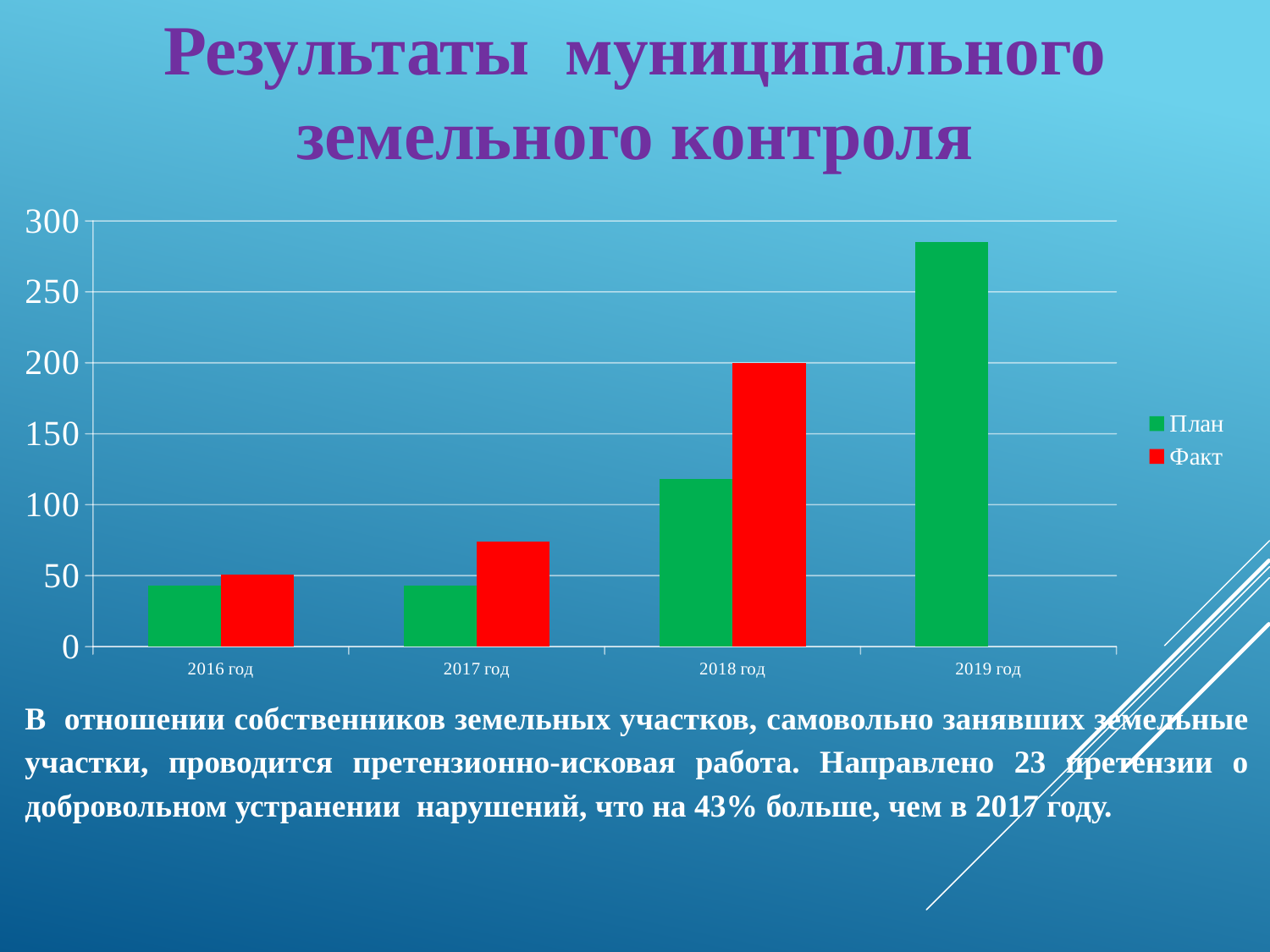
Is the План value for 2018 год greater or less than 100? greater Which colour represents the Факт series in the legend? red How many year categories are shown on the x axis? 4 Is the Факт value for 2017 год greater or less than 100? less Which year has the highest План value? 2019 год What kind of chart is shown on the slide? bar chart Does the План series rise or fall from 2017 год to 2019 год? rise Which year has the highest Факт value? 2018 год Which year has the lowest Факт value? 2016 год Which is larger for 2018 год, План or Факт? Факт Is the План value for 2019 год greater or less than 250? greater How many series does the legend list? 2